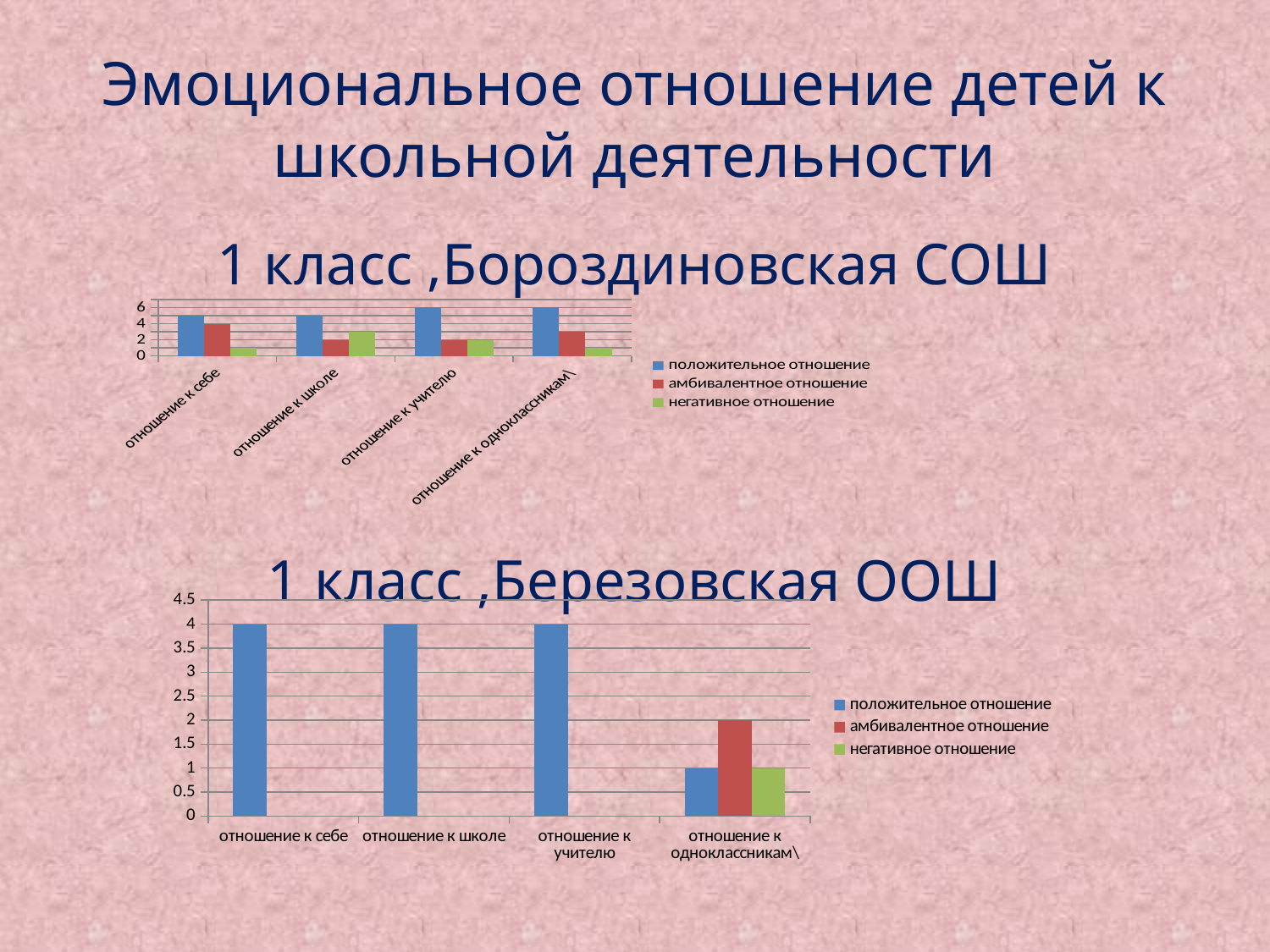
On the chart titled '1 класс ,Березовская ООШ', what is the value of 'негативное отношение' for 'отношение к одноклассникам\'? 1 What kind of chart is the one titled '1 класс ,Бороздиновская СОШ'? bar chart On the chart titled '1 класс ,Березовская ООШ', how many categories are shown on the x axis? 4 On the chart titled '1 класс ,Березовская ООШ', what is the value of 'амбивалентное отношение' for 'отношение к одноклассникам\'? 2 On the chart titled '1 класс ,Березовская ООШ', what is the value of 'положительное отношение' for 'отношение к одноклассникам\'? 1 On the chart titled '1 класс ,Березовская ООШ', what is the value of 'положительное отношение' for 'отношение к себе'? 4 On the chart titled '1 класс ,Бороздиновская СОШ', is the value of 'негативное отношение' for 'отношение к себе' greater or less than 2? less On the chart titled '1 класс ,Березовская ООШ', what is the difference between 'положительное отношение' for 'отношение к школе' and 'положительное отношение' for 'отношение к одноклассникам\'? 3 On the chart titled '1 класс ,Бороздиновская СОШ', is the value of 'положительное отношение' for 'отношение к учителю' greater or less than 4? greater On the chart titled '1 класс ,Березовская ООШ', how many series does the legend list? 3 On the chart titled '1 класс ,Бороздиновская СОШ', which series is shown in green in the legend? негативное отношение On the chart titled '1 класс ,Березовская ООШ', which series has the highest value for 'отношение к одноклассникам\'? амбивалентное отношение